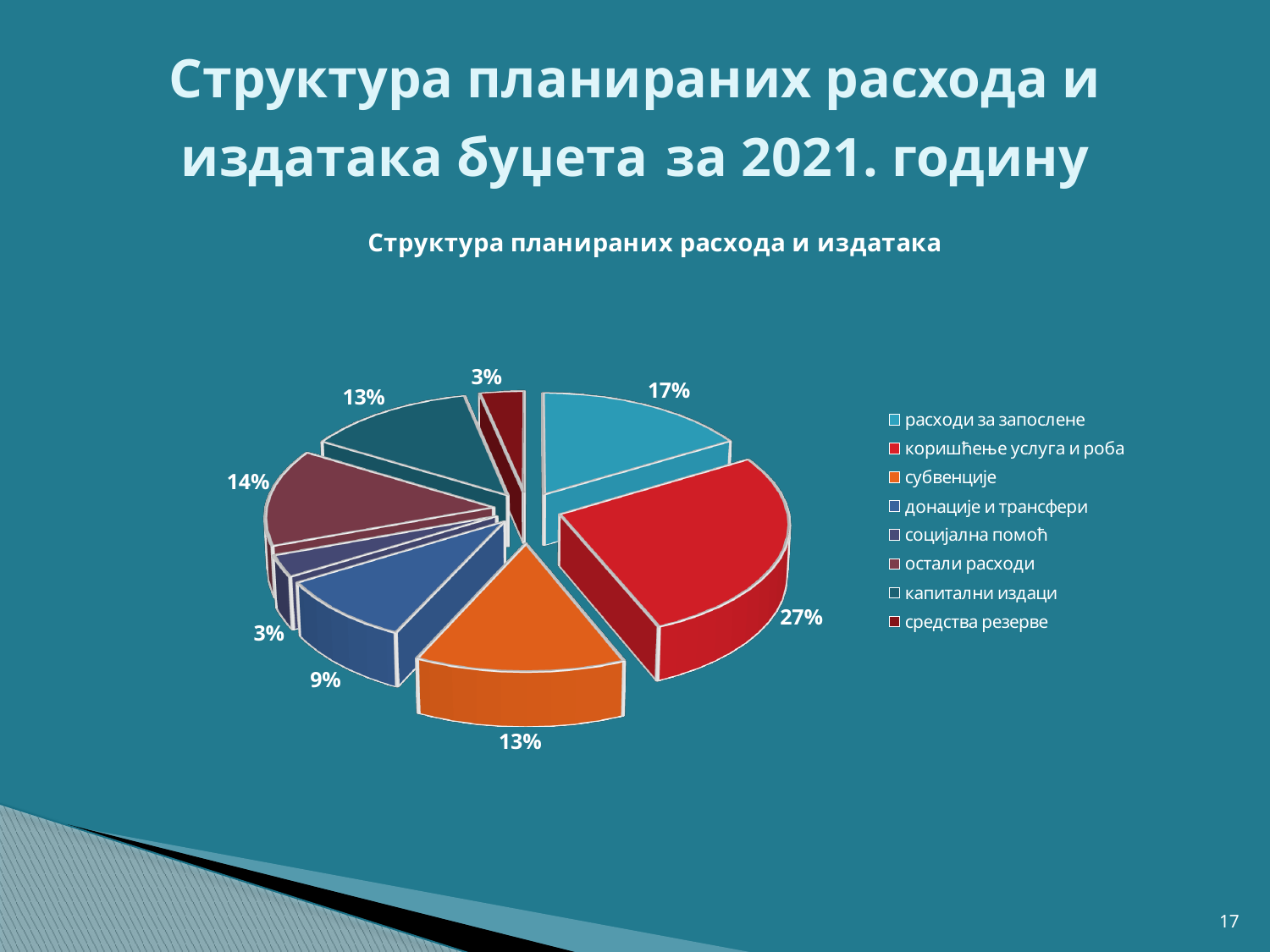
What share of the pie is донације и трансфери? 9% What share of the pie is расходи за запослене? 17% What share of the pie is остали расходи? 14% What is the title of the chart? Структура планираних расхода и издатака Which is larger, the share for остали расходи or the share for донације и трансфери? остали расходи What is the difference in percentage points between коришћење услуга и роба and расходи за запослене? 10 What type of chart is shown on the slide? pie chart Which category has the largest share of the pie? коришћење услуга и роба What colour is the slice for субвенције? orange What share of the pie is субвенције? 13% How many categories does the legend list? 8 What share of the pie is коришћење услуга и роба? 27%